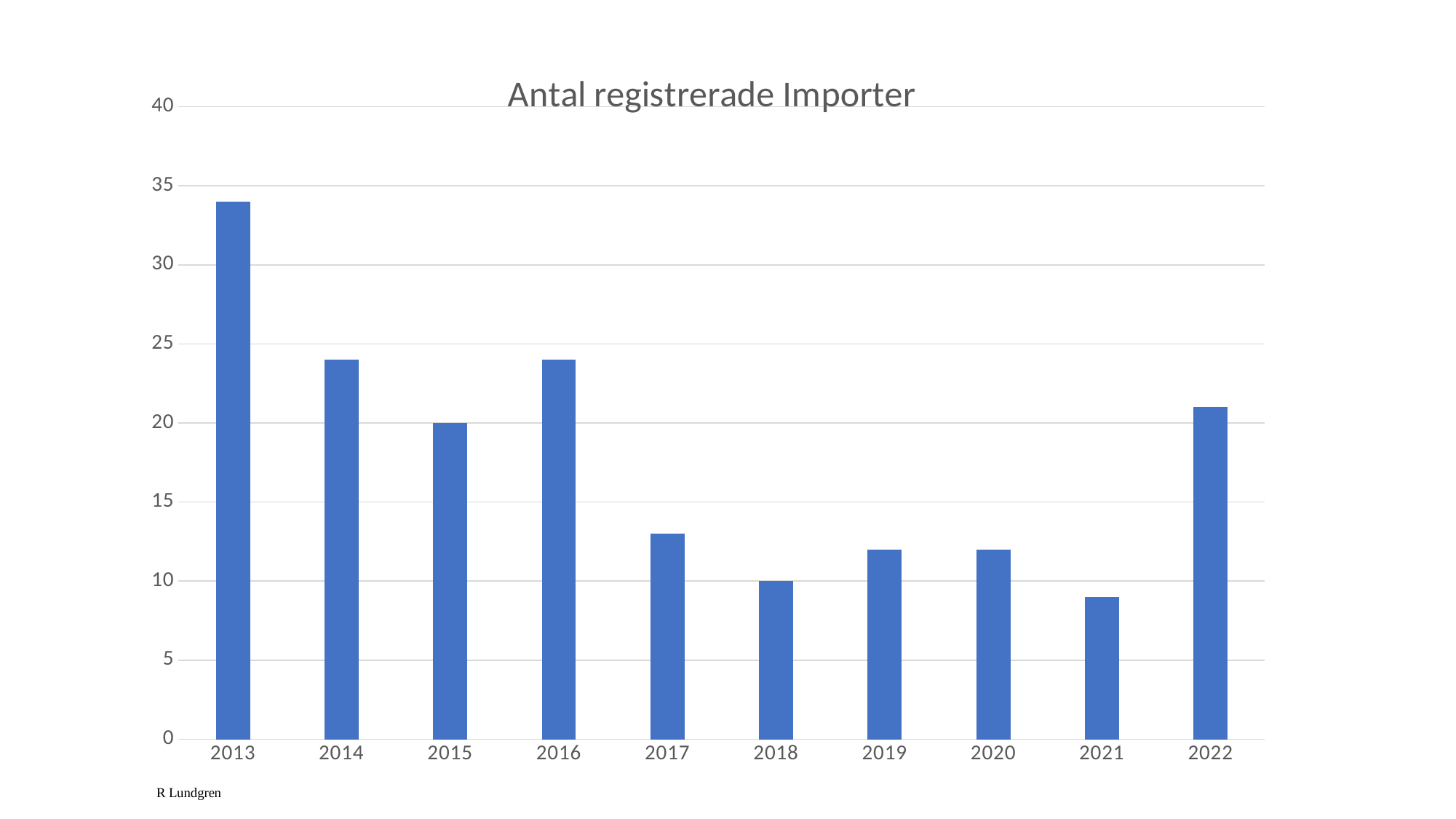
Is the value for 2017 greater or less than 15? less How many years are shown on the x axis of the chart? 10 What is the title of the chart? Antal registrerade Importer What kind of chart is shown on the slide? bar chart Do the values generally rise or fall from 2013 to 2018? fall Which year has a larger value, 2013 or 2022? 2013 Which year has the lowest number of registered imports? 2021 What is the value for 2015? 20 What is the value for 2018? 10 Which year has the highest number of registered imports? 2013 Is the value for 2013 greater or less than 30? greater Is the value for 2022 greater or less than 20? greater